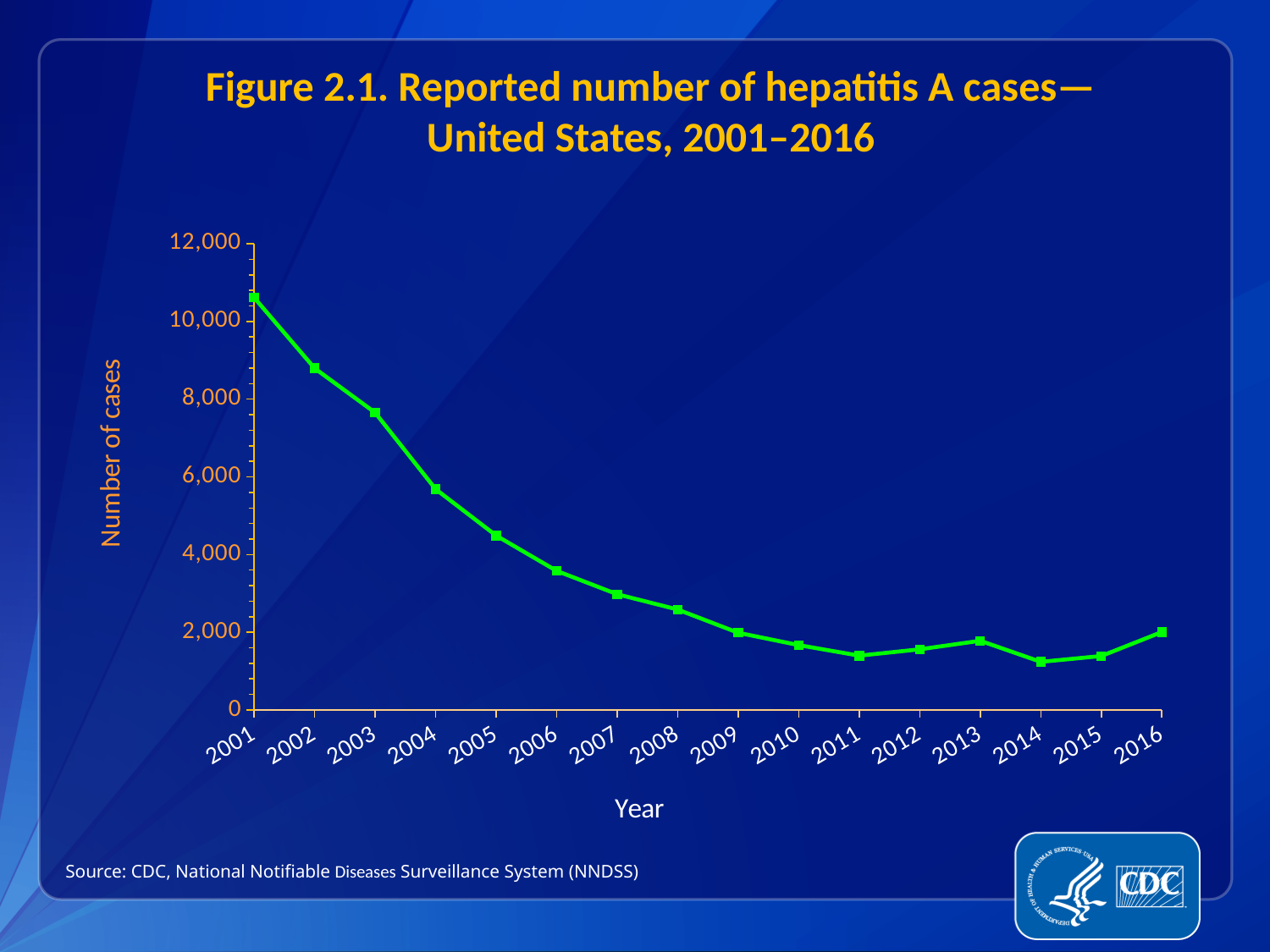
Which year has the highest reported number of hepatitis A cases? 2001 What kind of chart is shown on the slide? Line chart Which year has the lowest reported number of hepatitis A cases? 2014 Is the value for 2001 greater or less than 10,000? greater What is the label on the y axis? Number of cases Is the value for 2004 greater or less than 6,000? less Which year has more reported cases, 2013 or 2014? 2013 Which year has more reported cases, 2002 or 2005? 2002 Is the value for 2005 greater or less than 4,000? greater Do the reported cases rise or fall from 2001 to 2011? fall How many years are plotted on the x axis? 16